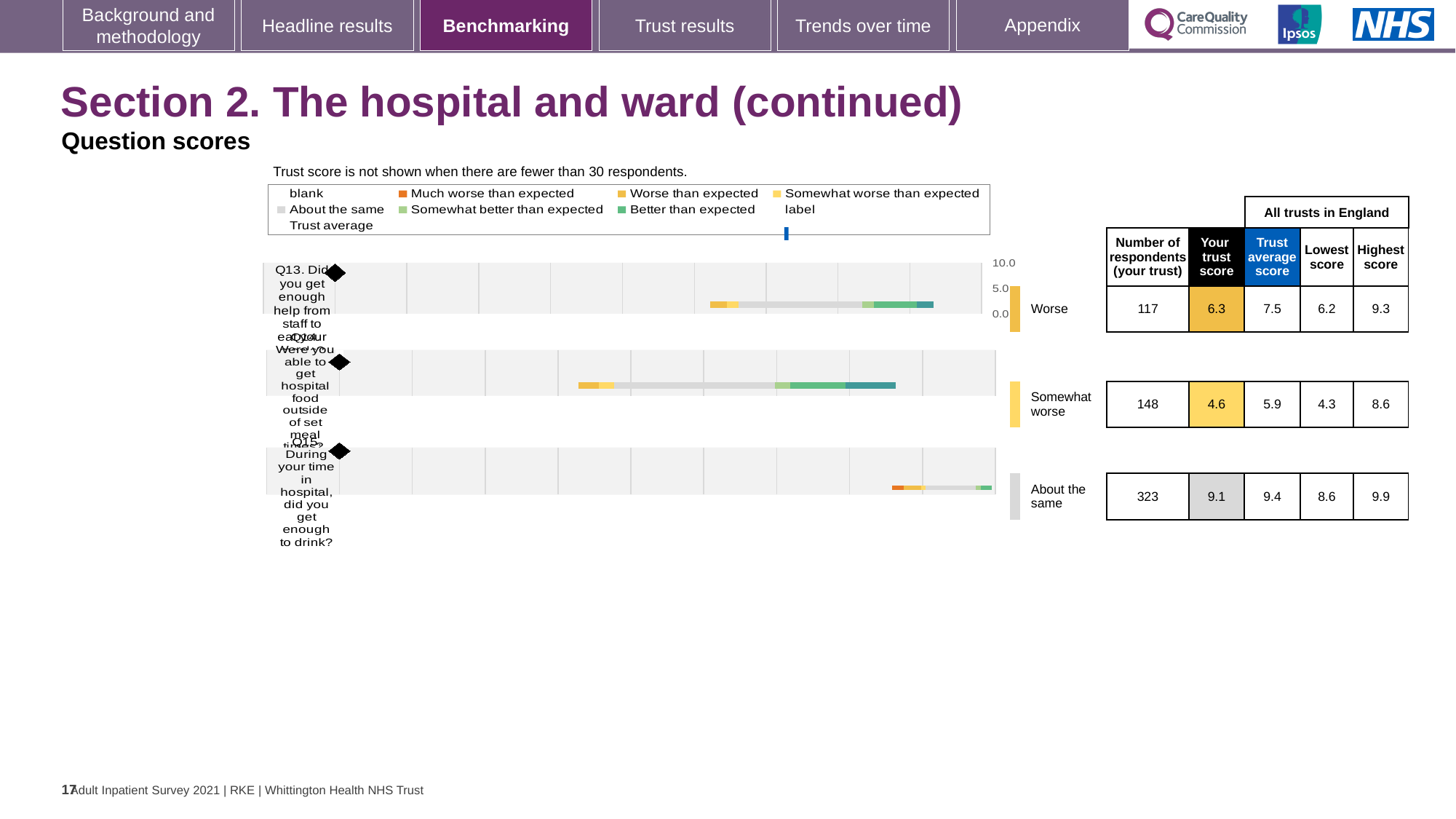
What is the difference between the highest score and the lowest score for Q13? 3.1 What is the trust score for Q15 (During your time in hospital, did you get enough to drink?)? 9.1 What kind of chart is shown? bar chart Is the trust score for Q14 larger or smaller than the trust average score for Q14? smaller Which of the three questions has the lowest trust score? Q14 What is the trust score for Q13 (Did you get enough help from staff to eat your meals?)? 6.3 What benchmark category is Q13 rated as? Worse What is the trust average score across all trusts in England for Q14? 5.9 What is the trust score for Q14 (Were you able to get hospital food outside of set meal times?)? 4.6 Which of the three questions has the highest trust score? Q15 How many respondents answered Q15 at this trust? 323 How many questions are plotted on the chart? 3